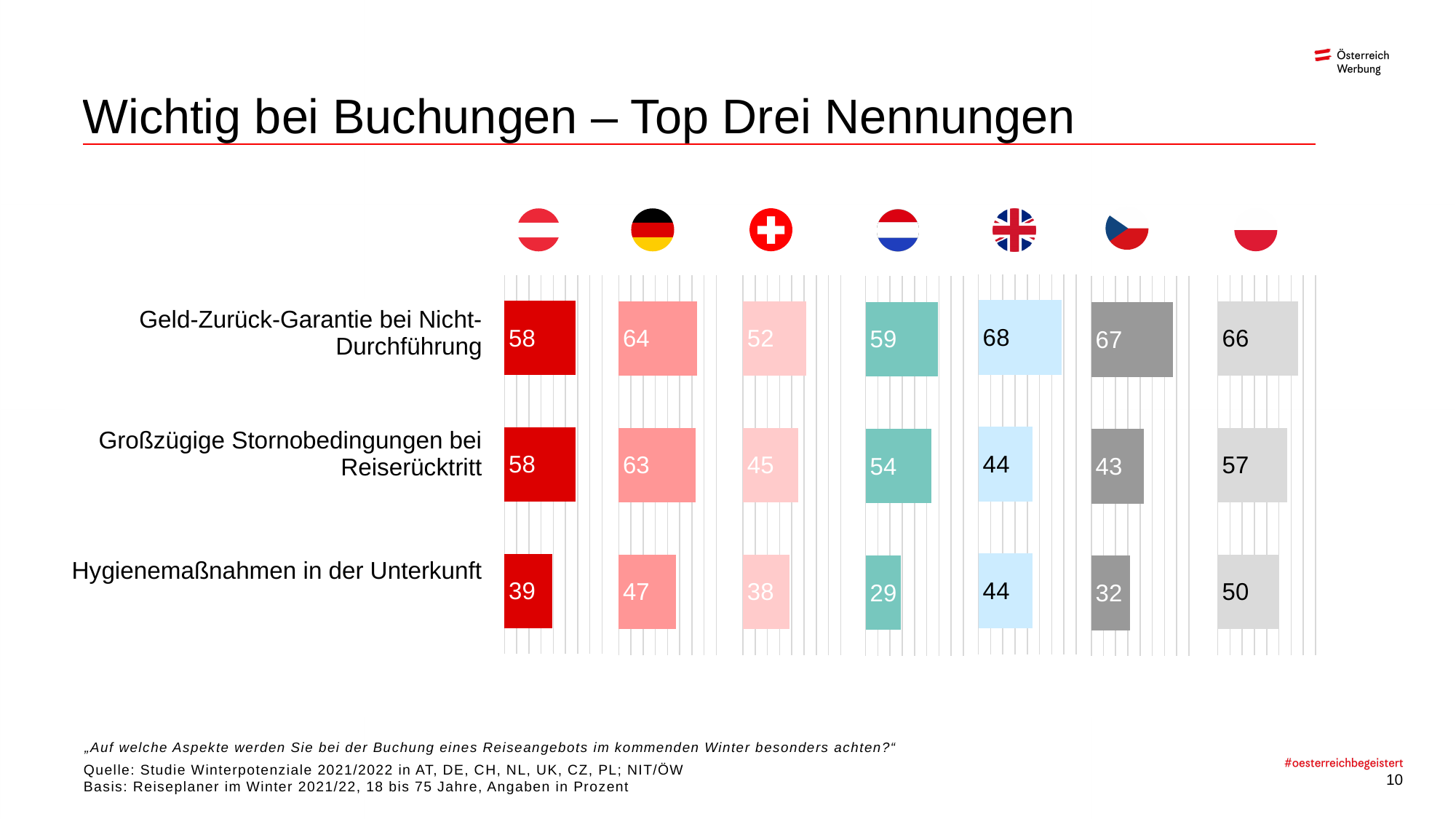
What is the difference between the UK and Switzerland values for "Geld-Zurück-Garantie bei Nicht-Durchführung"? 16 Which country has the highest value for "Geld-Zurück-Garantie bei Nicht-Durchführung"? UK What is the value for Germany for "Geld-Zurück-Garantie bei Nicht-Durchführung"? 64 Which is larger for "Großzügige Stornobedingungen bei Reiserücktritt": the value for Germany or the value for Czech Republic? Germany What is the title of the slide? Wichtig bei Buchungen – Top Drei Nennungen What is the difference between the Austria values for "Geld-Zurück-Garantie bei Nicht-Durchführung" and "Hygienemaßnahmen in der Unterkunft"? 19 How many countries are shown in the chart? 7 What is the value for the Netherlands for "Hygienemaßnahmen in der Unterkunft"? 29 What is the value for Poland for "Großzügige Stornobedingungen bei Reiserücktritt"? 57 Which country has the lowest value for "Hygienemaßnahmen in der Unterkunft"? Netherlands How many aspects (categories) are shown in the chart? 3 What kind of chart is shown on the slide? bar chart